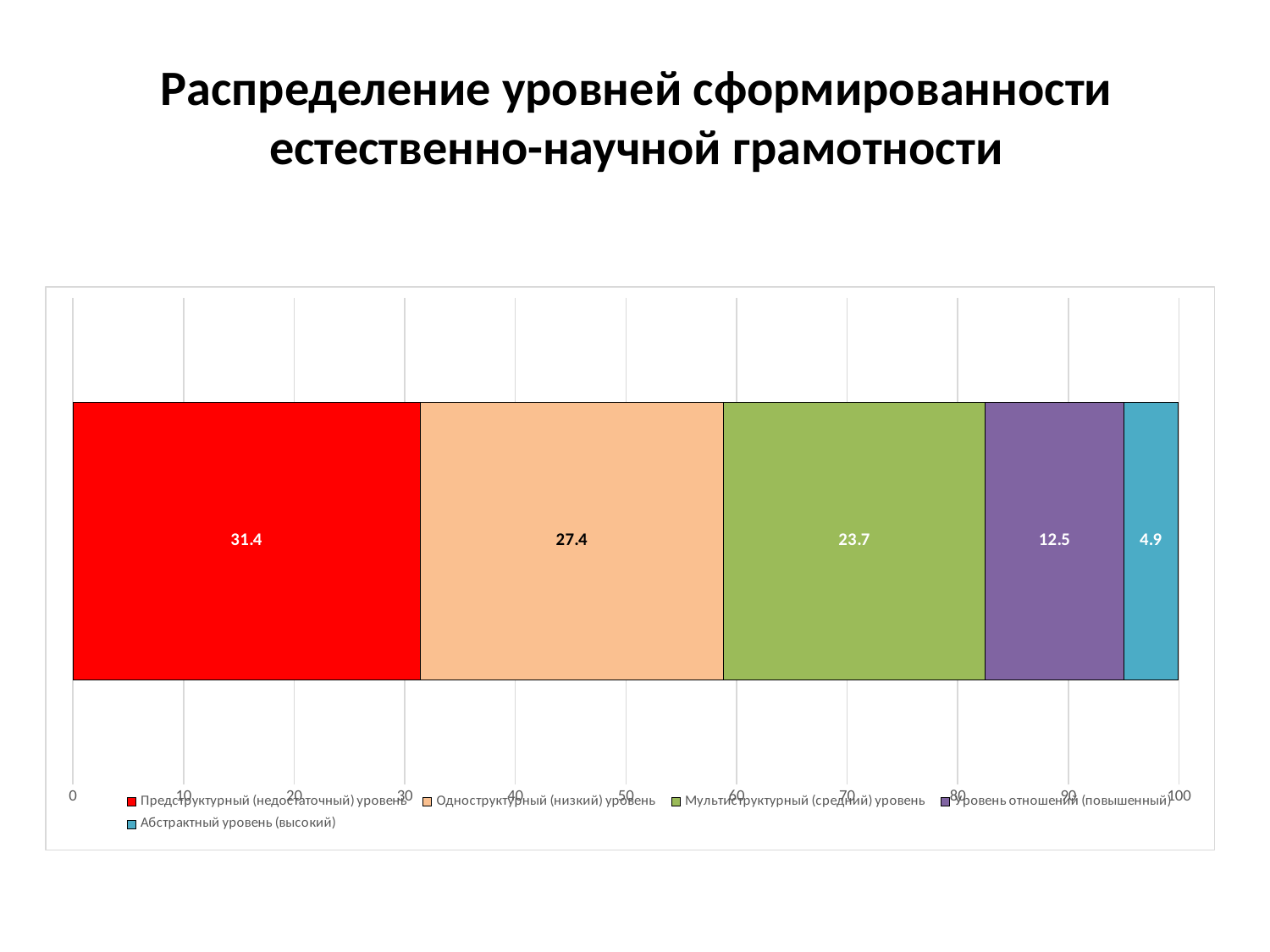
What is the difference between the Предструктурный (недостаточный) уровень value and the Одноструктурный (низкий) уровень value? 4.0 What value is shown for the Одноструктурный (низкий) уровень segment? 27.4 What value is shown for the Абстрактный уровень (высокий) segment? 4.9 What is the total of all segments in the stacked bar? 99.9 Which is larger: the value for Уровень отношений (повышенный) or the value for Абстрактный уровень (высокий)? Уровень отношений (повышенный) Which level has the lowest value? Абстрактный уровень (высокий) What is the title of the chart? Распределение уровней сформированности естественно-научной грамотности What kind of chart is shown on the slide? Stacked bar chart How many series does the legend list? 5 What value is shown for the Мультиструктурный (средний) уровень segment? 23.7 What value is shown for the Предструктурный (недостаточный) уровень segment? 31.4 Which level has the highest value? Предструктурный (недостаточный) уровень